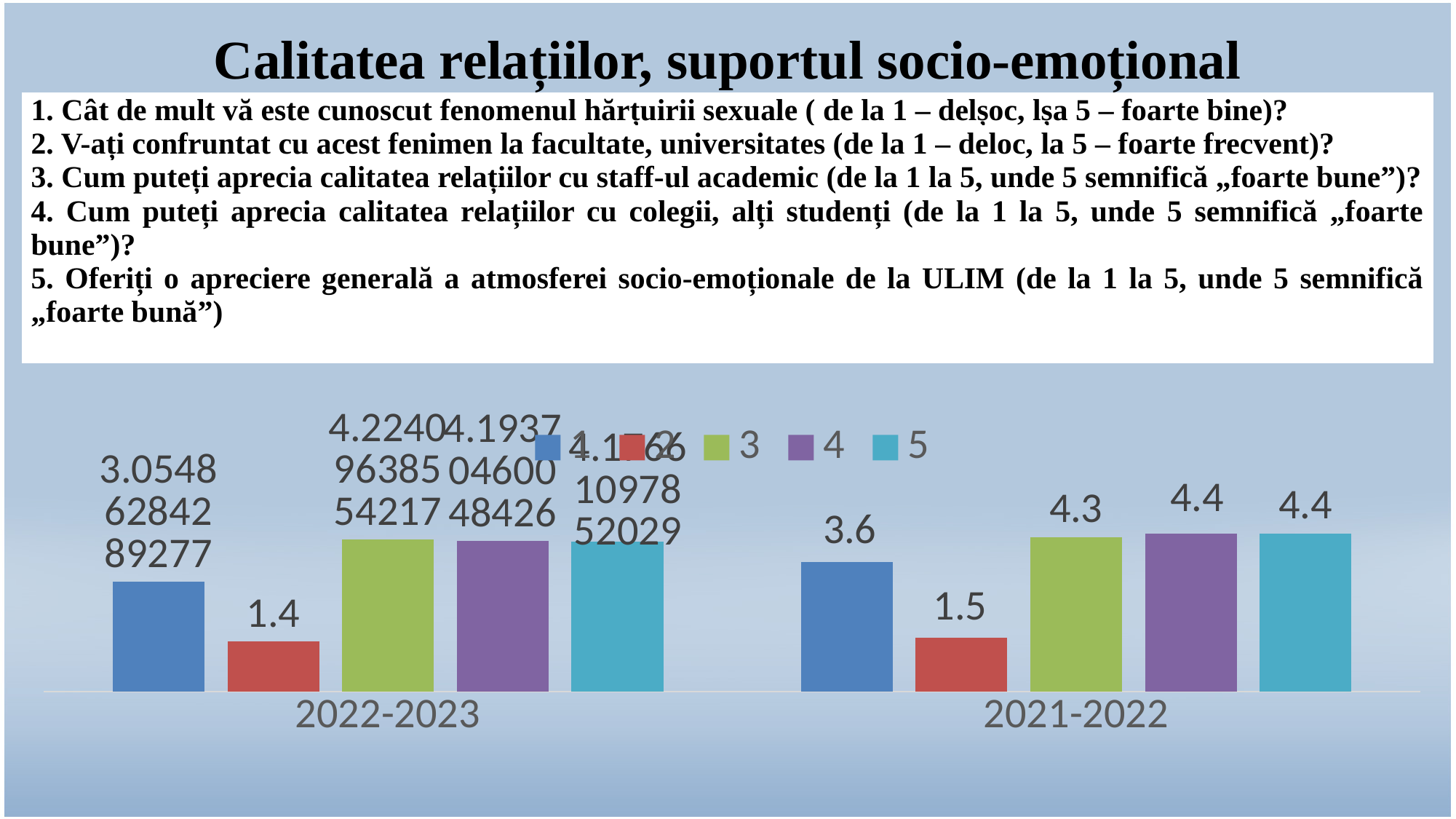
What is the value for series 2 in the 2022-2023 category? 1.4 Which series has the lowest value in the 2021-2022 category? 2 Which series has the lowest value in the 2022-2023 category? 2 What is the value for series 4 in the 2021-2022 category? 4.4 What is the value for series 2 in the 2021-2022 category? 1.5 What is the value for series 3 in the 2021-2022 category? 4.3 What is the value for series 1 in the 2021-2022 category? 3.6 What kind of chart is shown on the slide? bar chart Is the value for series 2 larger in 2022-2023 or in 2021-2022? 2021-2022 How many series does the legend list? 5 How many categories are shown on the x axis? 2 What is the difference between series 1 and series 2 in the 2021-2022 category? 2.1